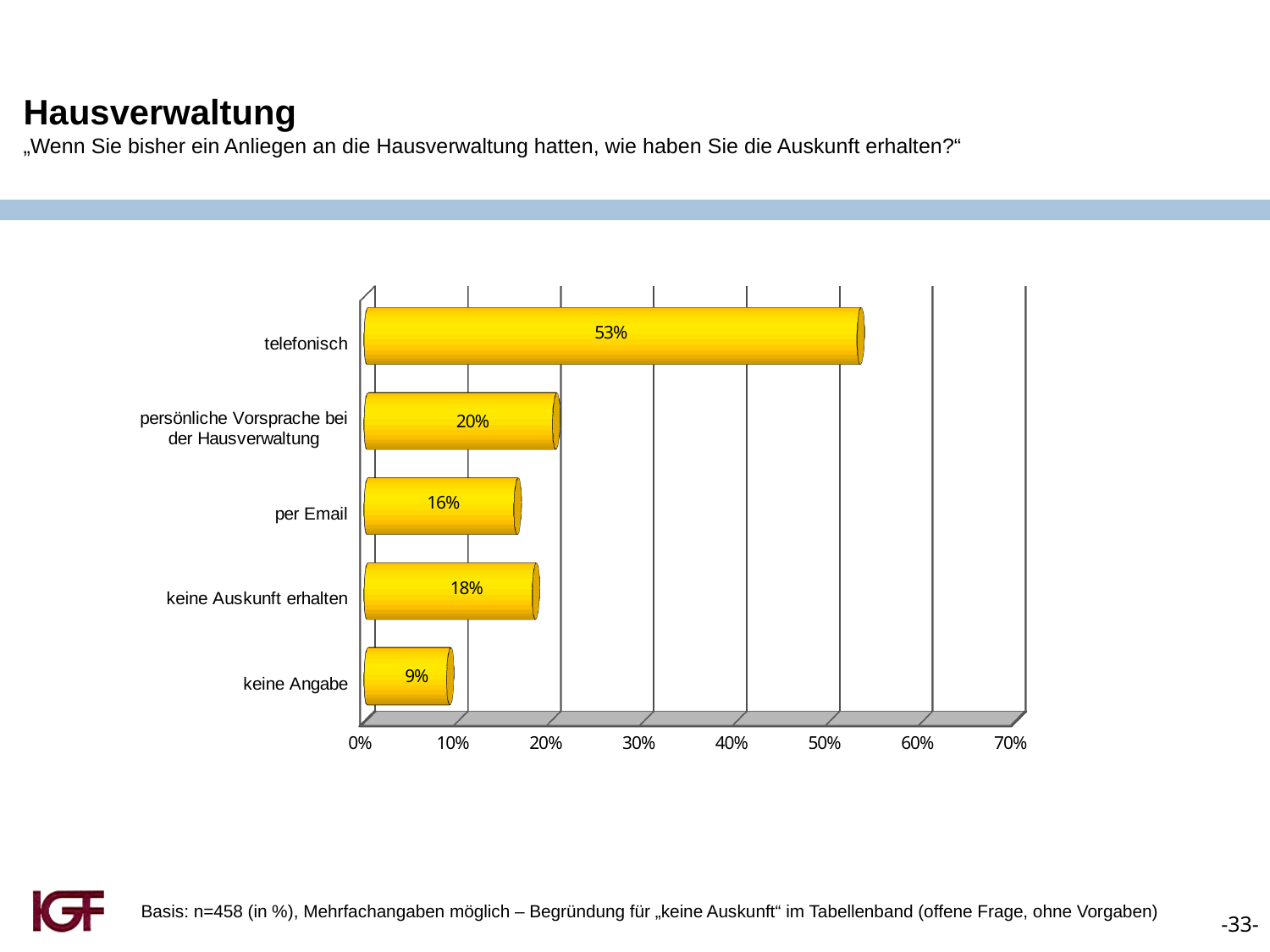
What kind of chart is shown on the slide? bar chart What is the value for "keine Angabe"? 9% How many categories are shown in the chart? 5 Which category has the lowest value? keine Angabe Which category has the highest value? telefonisch What is the difference between "telefonisch" and "persönliche Vorsprache bei der Hausverwaltung"? 33 percentage points What is the value for "per Email"? 16% What is the value for "telefonisch"? 53% What is the value for "persönliche Vorsprache bei der Hausverwaltung"? 20% What is the value for "keine Auskunft erhalten"? 18% What is the title of the slide? Hausverwaltung Which is larger: "per Email" or "keine Auskunft erhalten"? keine Auskunft erhalten